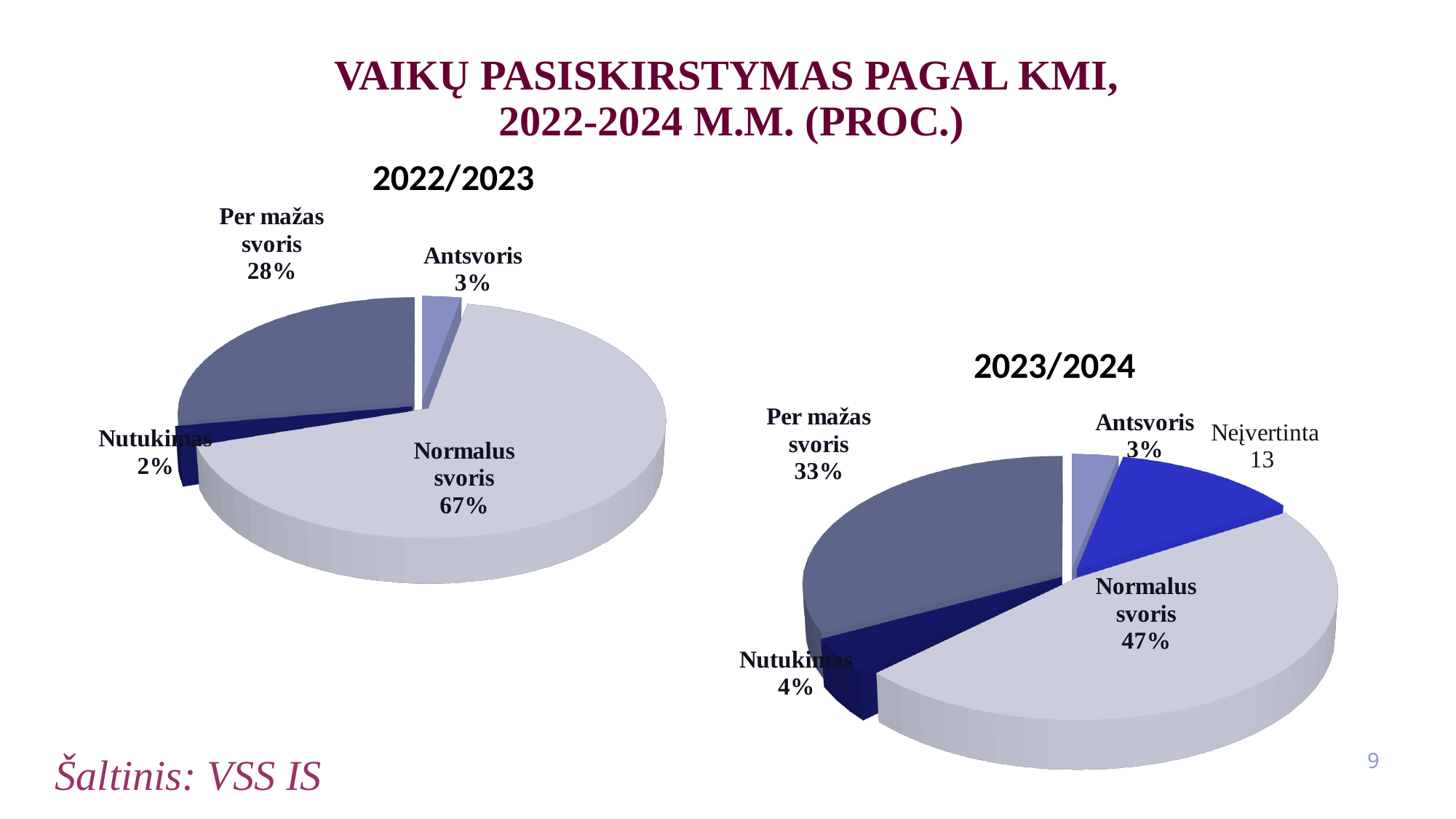
In the 2023/2024 pie chart, what is the value shown for Neįvertinta? 13 What is the difference between the Normalus svoris value in the 2022/2023 chart and in the 2023/2024 chart? 20% Is the Per mažas svoris share larger in the 2022/2023 chart or in the 2023/2024 chart? 2023/2024 How many categories are shown in the 2023/2024 pie chart? 5 In the 2022/2023 pie chart, which category has the smallest share? Nutukimas In the 2023/2024 pie chart, which category has the largest share? Normalus svoris In the 2022/2023 pie chart, what is the value for Per mažas svoris? 28% In the 2023/2024 pie chart, what is the value for Nutukimas? 4% What kind of chart is used for the 2022/2023 data? Pie chart In the 2022/2023 pie chart, what is the value for Normalus svoris? 67% In the 2022/2023 pie chart, which category has the largest share? Normalus svoris What is the title of the slide containing the two pie charts? VAIKŲ PASISKIRSTYMAS PAGAL KMI, 2022-2024 M.M. (PROC.)